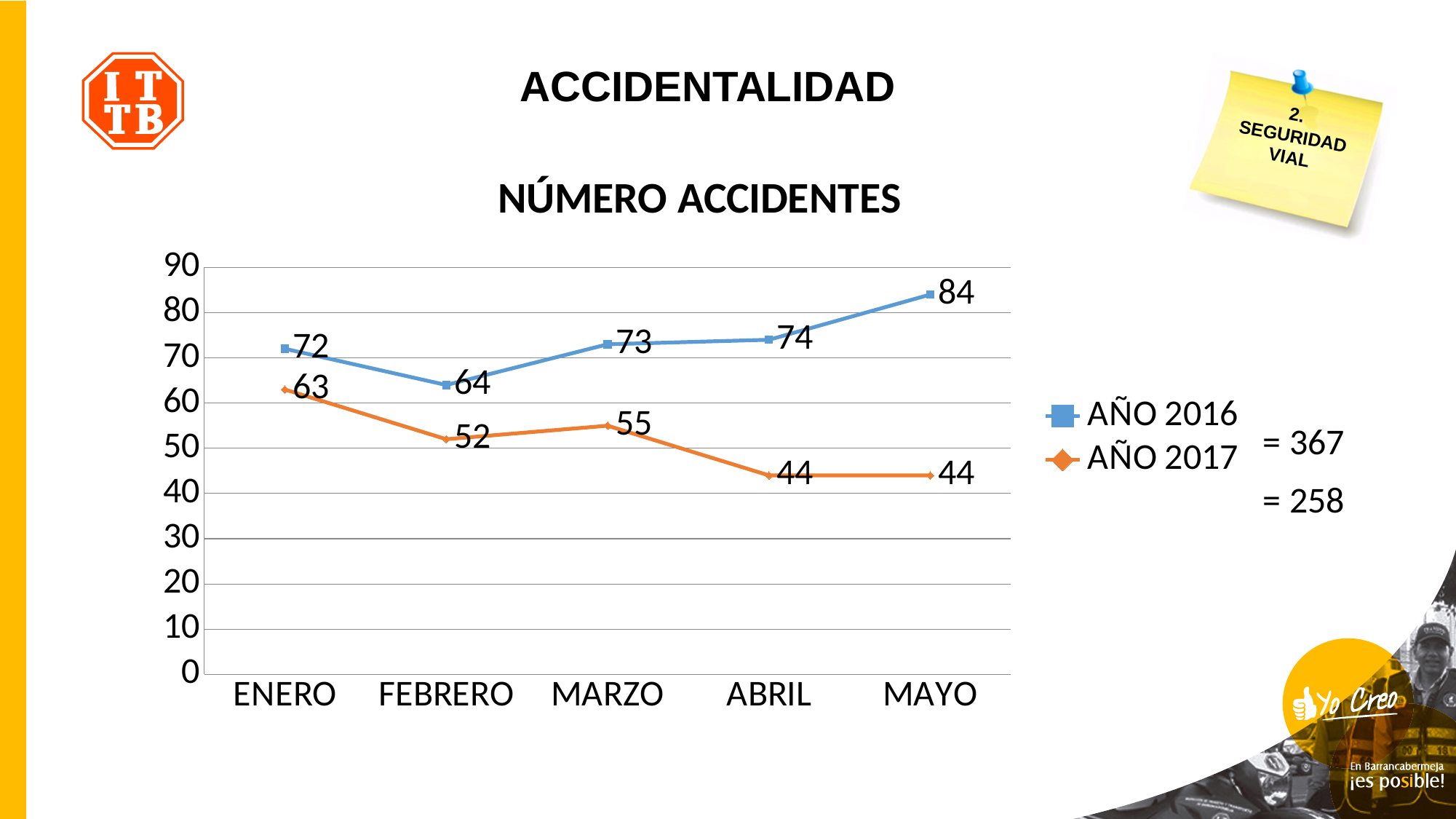
How many series does the legend list? 2 Which is larger, the AÑO 2017 value in MARZO or the AÑO 2017 value in FEBRERO? MARZO What is the difference between AÑO 2016 and AÑO 2017 in MAYO? 40 Does the AÑO 2017 series rise or fall from ENERO to ABRIL? Fall What is the value for AÑO 2016 in MAYO? 84 Which month has the highest value for AÑO 2016? MAYO Which month has the lowest value for AÑO 2017? ABRIL and MAYO (both 44) What is the title of the chart? NÚMERO ACCIDENTES What is the value for AÑO 2017 in FEBRERO? 52 What kind of chart is shown? Line chart How many months are shown on the x axis? 5 What is the value for AÑO 2016 in ENERO? 72